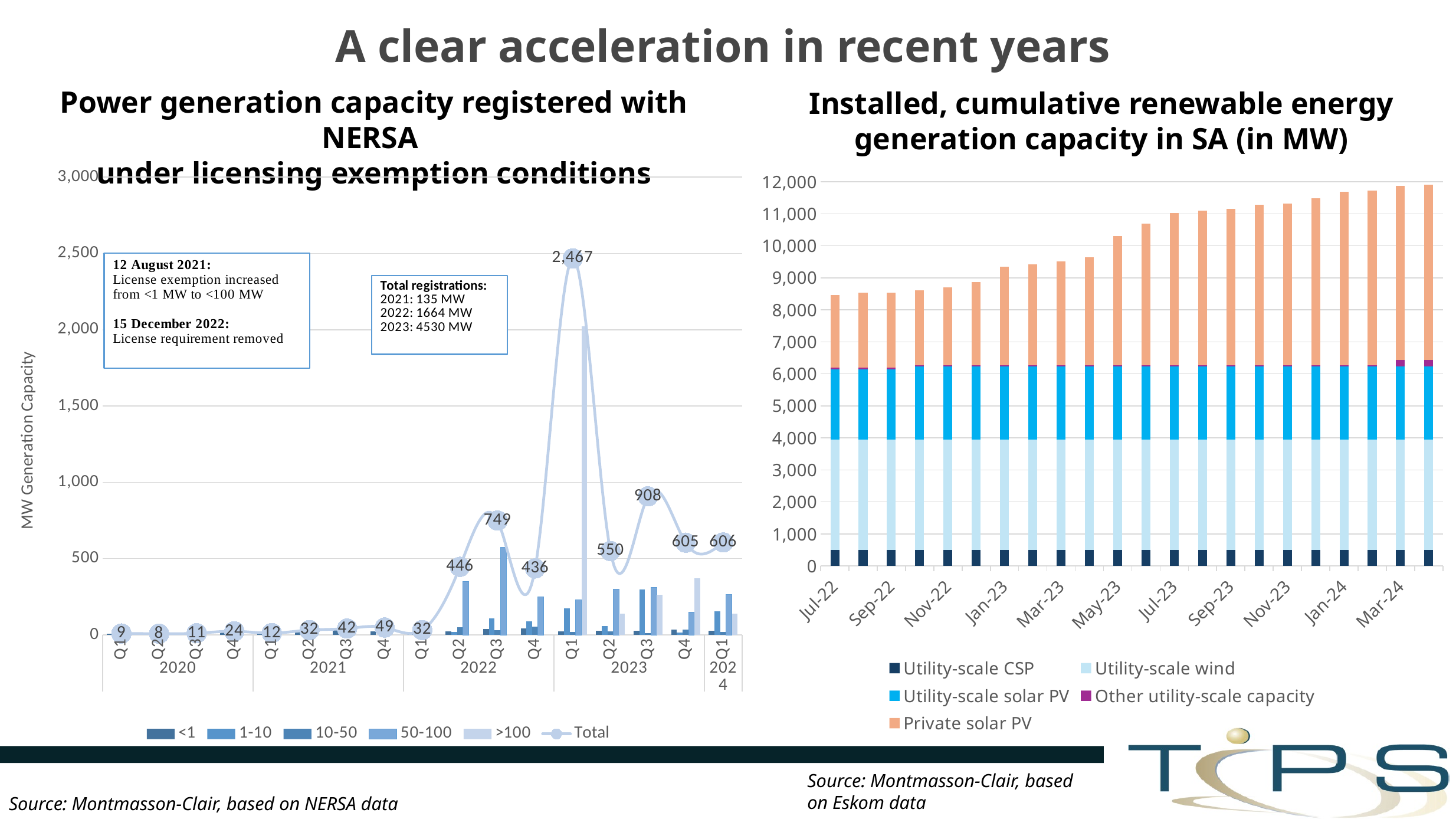
In the left chart (Power generation capacity registered with NERSA), which quarter has the highest Total? Q1 2023 What kind of chart is the right chart (Installed, cumulative renewable energy generation capacity in SA)? Stacked bar chart In the left chart (Power generation capacity registered with NERSA), what is the Total value for Q1 2023? 2,467 In the left chart (Power generation capacity registered with NERSA), what is the Total value for Q4 2021? 49 In the right chart (Installed, cumulative renewable energy generation capacity in SA), do the total bar heights rise or fall from Jul-22 to Mar-24? Rise How many series does the legend of the right chart (Installed, cumulative renewable energy generation capacity in SA) list? 5 In the left chart (Power generation capacity registered with NERSA), what is the Total value for Q3 2022? 749 In the left chart (Power generation capacity registered with NERSA), what is the difference between the Total for Q3 2023 and the Total for Q2 2023? 358 How many series does the legend of the left chart (Power generation capacity registered with NERSA) list? 6 In the left chart (Power generation capacity registered with NERSA), what is the Total value for Q1 2024? 606 In the right chart (Installed, cumulative renewable energy generation capacity in SA), is the total bar for Jul-22 greater or less than 9,000? less In the left chart (Power generation capacity registered with NERSA), which is larger: the Total for Q3 2022 or the Total for Q4 2022? Q3 2022